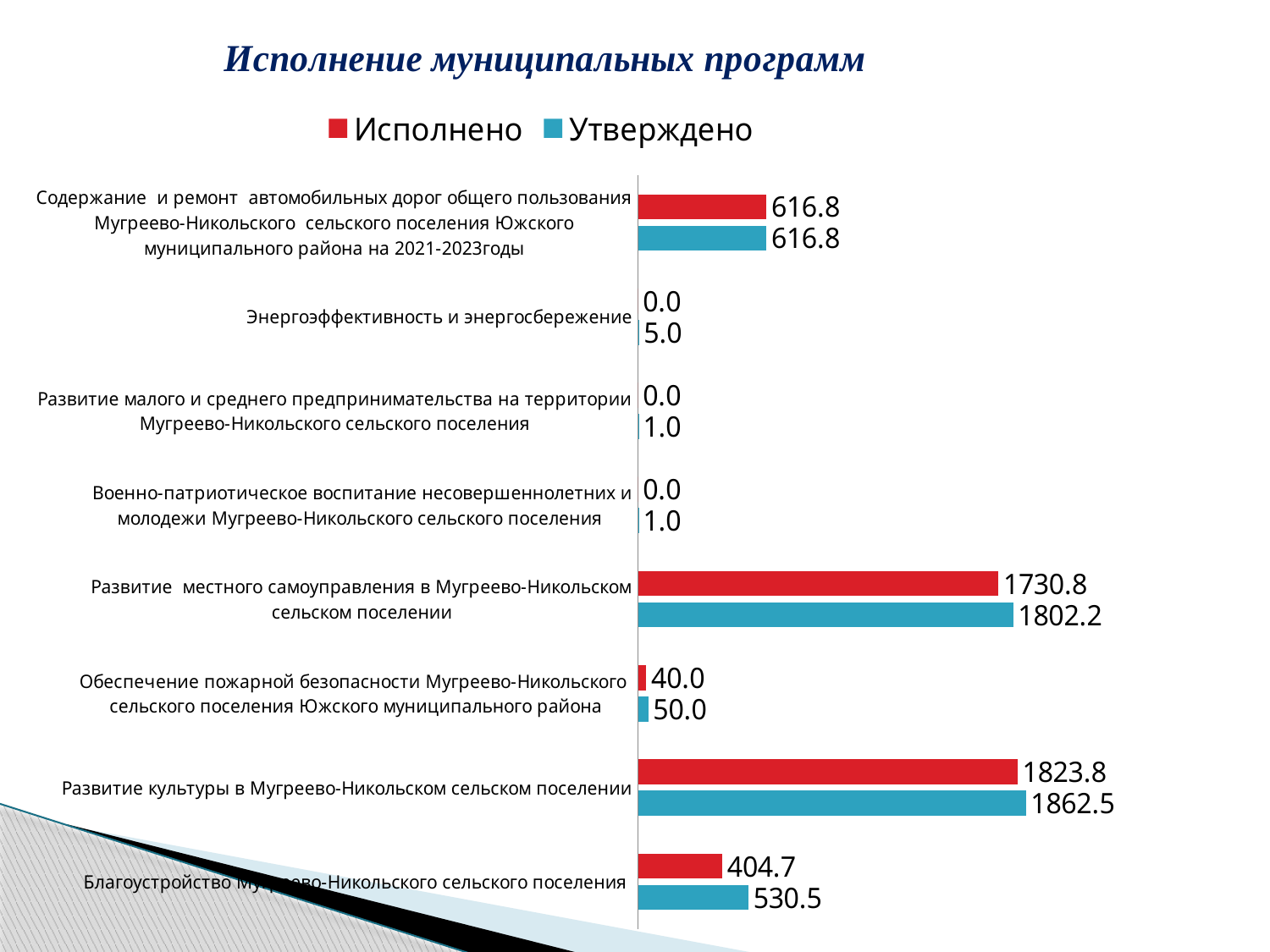
What kind of chart is shown on the slide? Bar chart What is the difference between the Утверждено and Исполнено values for Благоустройство Мугреево-Никольского сельского поселения? 125.8 What is the Исполнено value for Обеспечение пожарной безопасности Мугреево-Никольского сельского поселения Южского муниципального района? 40.0 What is the Исполнено value for Благоустройство Мугреево-Никольского сельского поселения? 404.7 What is the difference between the Утверждено and Исполнено values for Развитие местного самоуправления в Мугреево-Никольском сельском поселении? 71.4 How many categories are shown in the chart? 8 How many series does the legend list? 2 What is the Утверждено value for Развитие культуры в Мугреево-Никольском сельском поселении? 1862.5 Which category has the highest Исполнено value? Развитие культуры в Мугреево-Никольском сельском поселении What is the Утверждено value for Энергоэффективность и энергосбережение? 5.0 Which is larger for Развитие культуры в Мугреево-Никольском сельском поселении: the Исполнено value or the Утверждено value? Утверждено